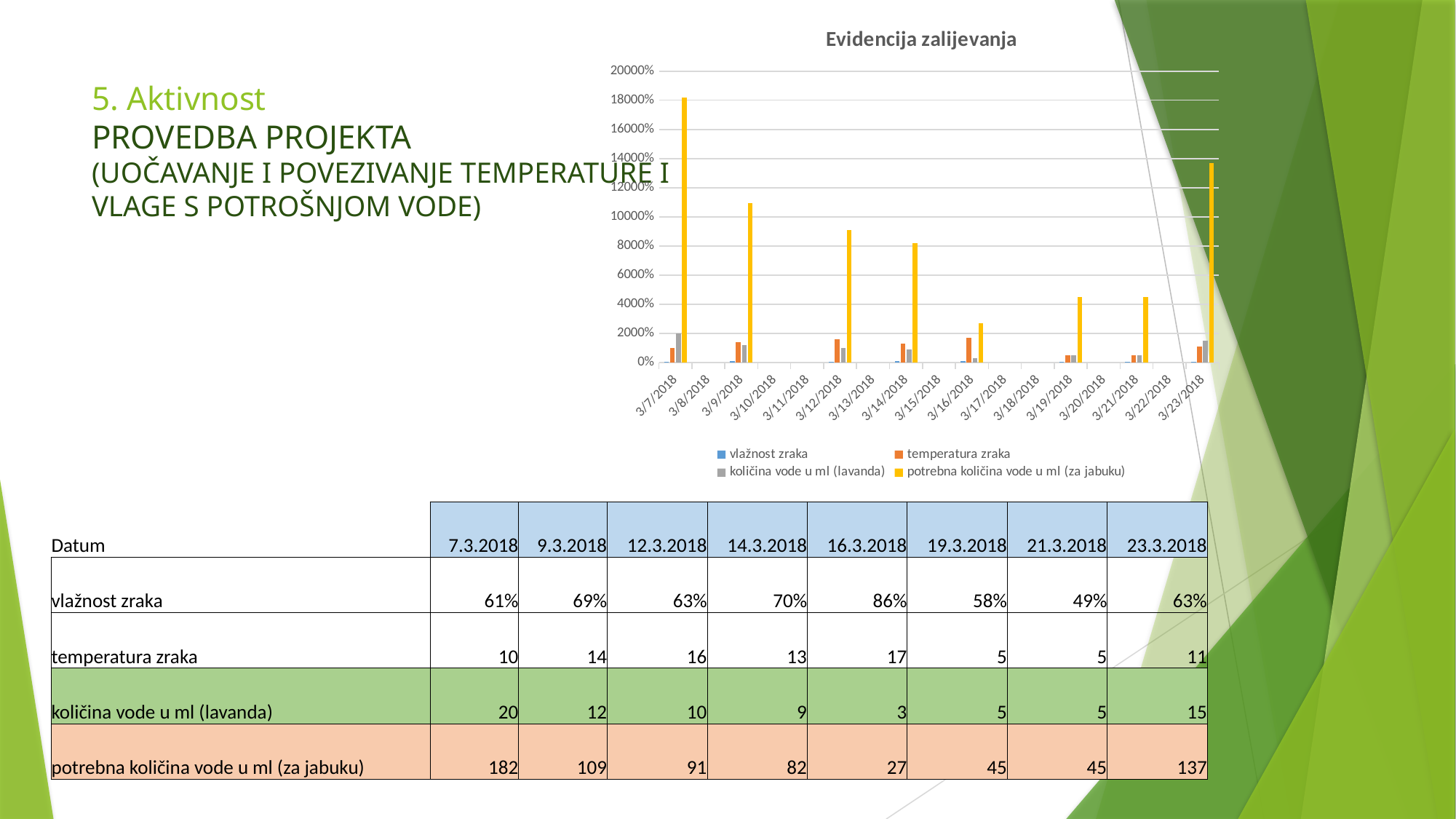
How many series does the chart legend list? 4 What is the title of the chart on the slide? Evidencija zalijevanja What kind of chart is shown on the slide? bar chart Is the 'potrebna količina vode u ml (za jabuku)' bar for 3/23/2018 greater or less than 12000%? greater How many dates are shown along the x axis of the chart? 17 On which date is the bar for 'potrebna količina vode u ml (za jabuku)' the tallest? 3/7/2018 Which series is drawn in yellow in the chart? potrebna količina vode u ml (za jabuku) Do the 'potrebna količina vode u ml (za jabuku)' bars rise or fall from 3/7/2018 to 3/16/2018? fall Is the 'potrebna količina vode u ml (za jabuku)' bar for 3/16/2018 greater or less than 4000%? less Which is taller: the 'potrebna količina vode u ml (za jabuku)' bar for 3/12/2018 or for 3/14/2018? 3/12/2018 Among the dates with bars, on which date is the 'potrebna količina vode u ml (za jabuku)' bar the shortest? 3/16/2018 Is the 'potrebna količina vode u ml (za jabuku)' bar for 3/7/2018 greater or less than 16000%? greater